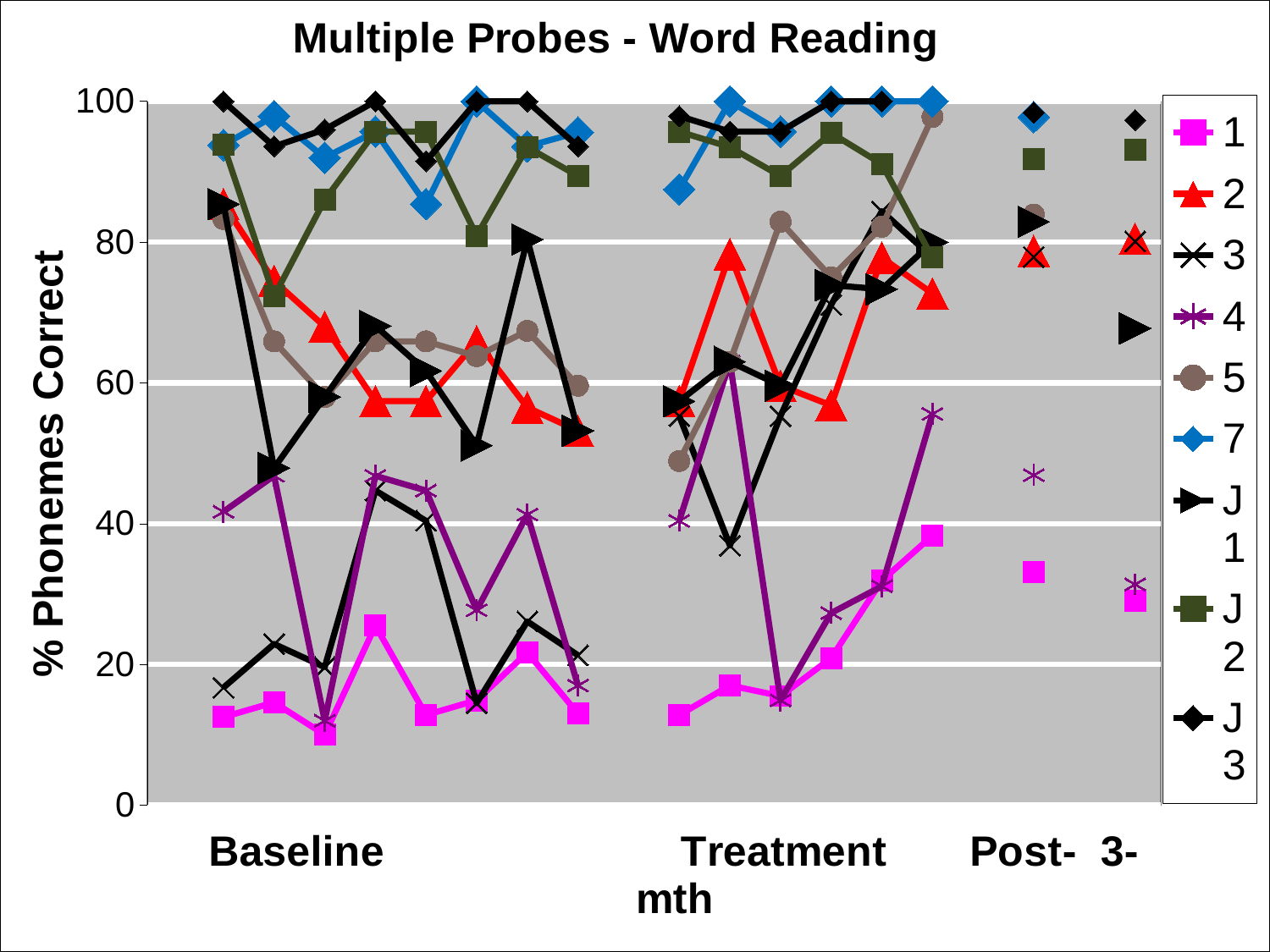
Is the value for series J3 at the Post- probe greater or less than 80? greater Is the value for series 7 at the first Baseline probe greater or less than 80? greater Is the value for series 1 at the first Baseline probe greater or less than 20? less What kind of chart is shown on the slide? line chart Which series has the lowest values throughout the Baseline phase? 1 Do the values for series 1 rise or fall across the Treatment phase? rise How many series does the legend list? 9 What is the label on the y axis? % Phonemes Correct At the first Baseline probe, which is larger: the value for series 7 or the value for series 1? series 7 What is the title of the chart? Multiple Probes - Word Reading